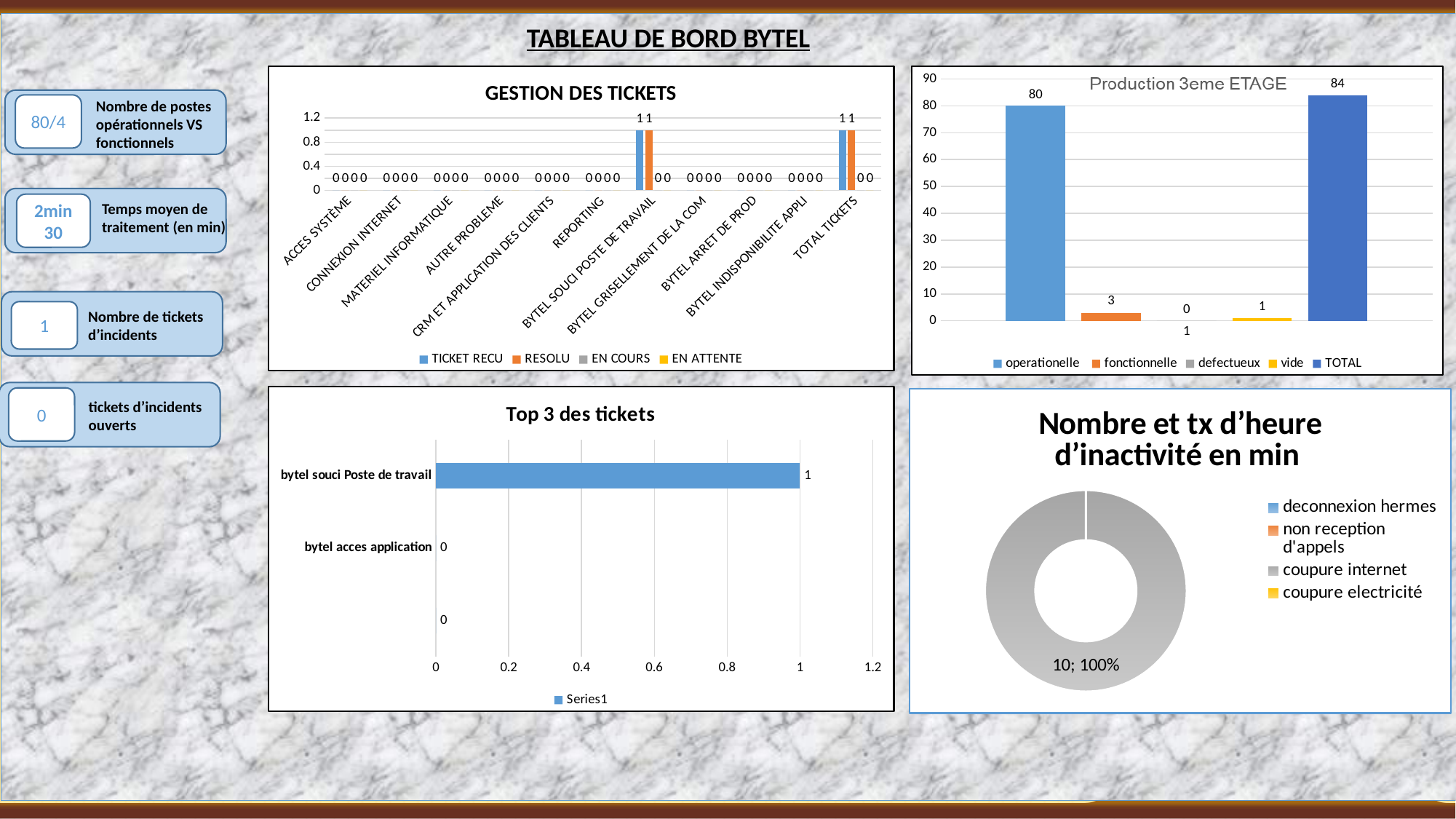
In the 'GESTION DES TICKETS' chart, how many categories are shown on the x axis? 11 In the 'Nombre et tx d'heure d'inactivité en min' chart, what share does the coupure internet slice have? 100% In the 'Production 3eme ETAGE' chart, what is the value for operationnelle? 80 In the 'Production 3eme ETAGE' chart, which series has the highest value? TOTAL In the 'GESTION DES TICKETS' chart, how many series does the legend list? 4 In the 'Production 3eme ETAGE' chart, what is the value for TOTAL? 84 How many series does the legend of the 'Production 3eme ETAGE' chart list? 5 In the 'Production 3eme ETAGE' chart, what is the difference between TOTAL and operationnelle? 4 In the 'Production 3eme ETAGE' chart, what is the value for fonctionnelle? 3 In the 'GESTION DES TICKETS' chart, what is the TICKET RECU value for BYTEL SOUCI POSTE DE TRAVAIL? 1 In the 'Top 3 des tickets' chart, what is the value for bytel souci Poste de travail? 1 What kind of chart is 'Top 3 des tickets'? bar chart